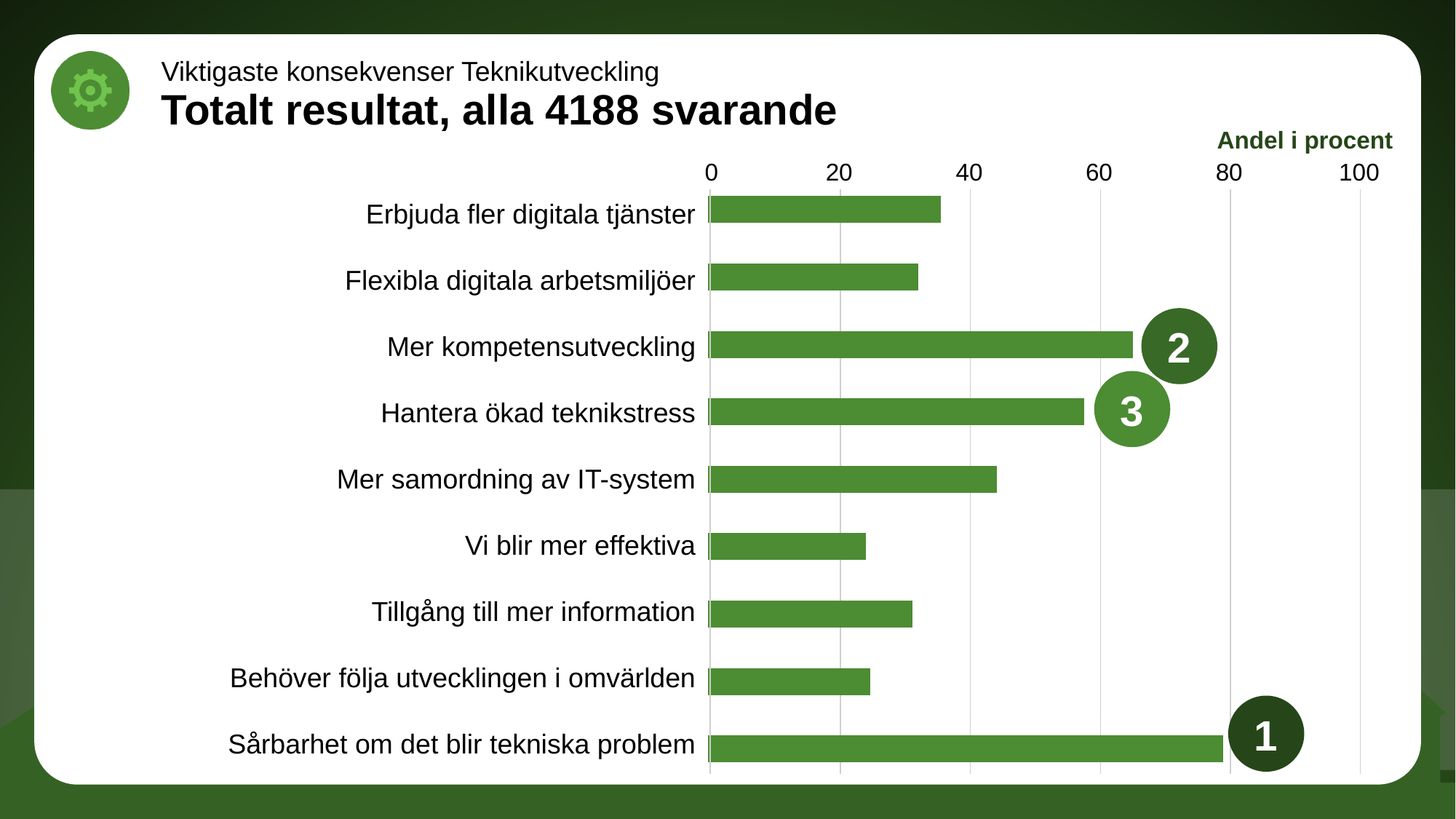
How many categories are plotted in the chart? 9 Which category has the highest value in the chart? Sårbarhet om det blir tekniska problem What unit label is shown above the chart's value axis? Andel i procent Is the value for Mer samordning av IT-system greater or less than 40? greater Is the value for Sårbarhet om det blir tekniska problem greater or less than 60? greater Is the value for Hantera ökad teknikstress greater or less than 40? greater Which is larger, the value for Mer samordning av IT-system or the value for Tillgång till mer information? Mer samordning av IT-system Which is larger, the value for Mer kompetensutveckling or the value for Hantera ökad teknikstress? Mer kompetensutveckling What kind of chart is shown on the slide? bar chart